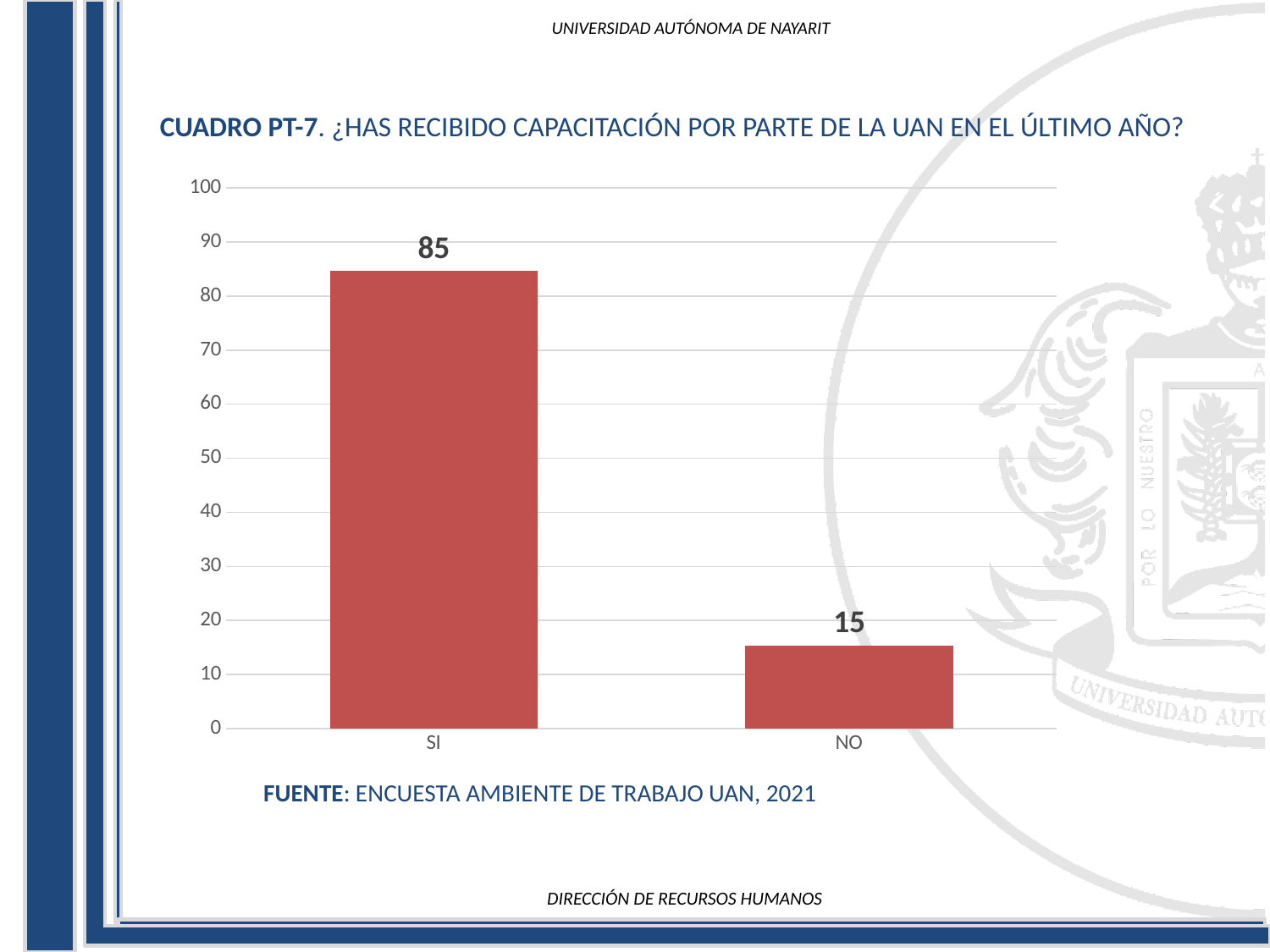
What is the value for NO? 15 What is the source cited below the chart? ENCUESTA AMBIENTE DE TRABAJO UAN, 2021 What is the value for SI? 85 Which category has the highest value? SI What is the total of the two bar values? 100 Which is larger, the value for SI or the value for NO? SI What kind of chart is shown on the slide? bar chart What is the difference between the values for SI and NO? 70 Is the value for SI greater or less than 80? greater Which category has the lowest value? NO Is the value for NO greater or less than 20? less How many categories are shown on the x axis? 2